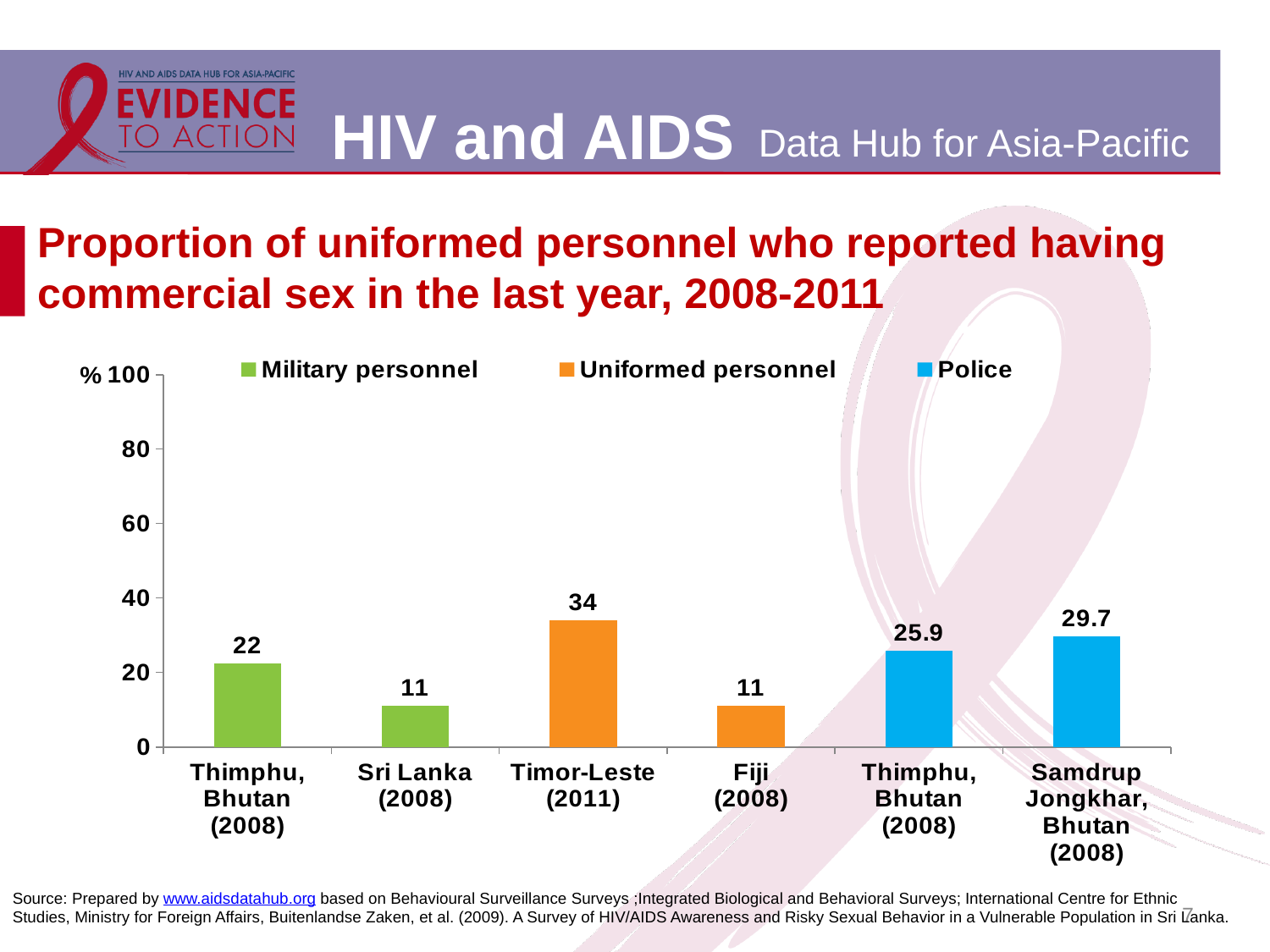
What is the value for the Police bar for Thimphu, Bhutan (2008)? 25.9 How many bars are plotted in the chart? 6 What is the value for the Military personnel bar for Thimphu, Bhutan (2008)? 22 Which category has the highest value? Timor-Leste (2011) What is the value for Samdrup Jongkhar, Bhutan (2008)? 29.7 What kind of chart is shown on the slide? bar chart Which is larger, the value for Samdrup Jongkhar, Bhutan (2008) or the Police value for Thimphu, Bhutan (2008)? Samdrup Jongkhar, Bhutan (2008) Is the value for Sri Lanka (2008) greater or less than 20? less What is the value for Timor-Leste (2011)? 34 Which series is shown in orange in the legend? Uniformed personnel What is the difference between the values for Timor-Leste (2011) and Fiji (2008)? 23 How many series does the legend list? 3